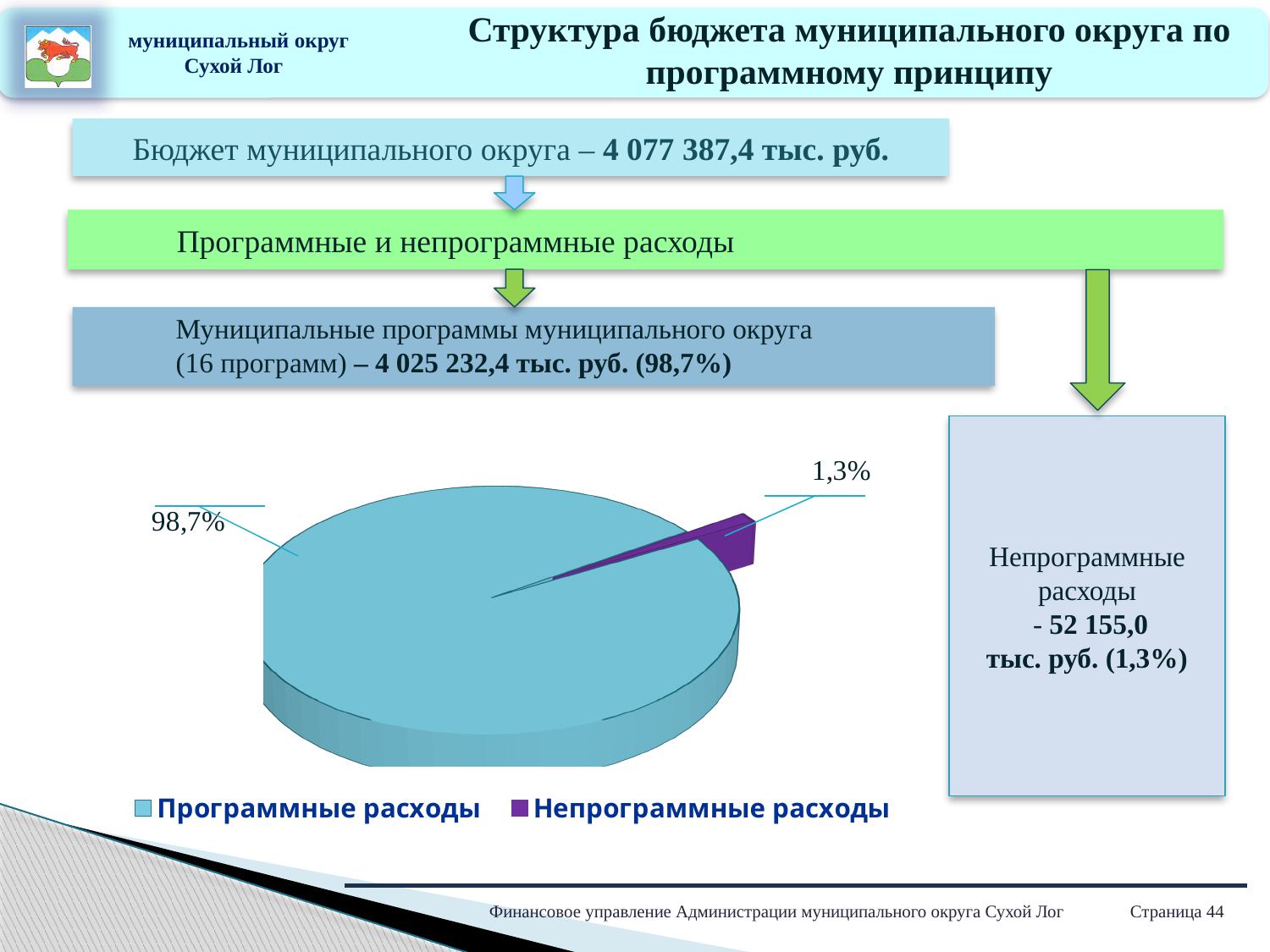
What kind of chart is shown on the slide? pie chart What is the first entry listed in the chart legend? Программные расходы How many slices does the pie chart have? 2 Which slice of the pie chart is the smallest? Непрограммные расходы What is the total of the two slice percentages shown on the pie chart? 100% Which is larger in the pie chart: Программные расходы or Непрограммные расходы? Программные расходы What share of the pie does Программные расходы take? 98,7% What colour is the Непрограммные расходы slice in the pie chart? purple What share of the pie does Непрограммные расходы take? 1,3% What is the difference in percentage points between the Программные расходы slice and the Непрограммные расходы slice? 97,4% Which slice of the pie chart is the largest? Программные расходы How many entries does the chart legend list? 2